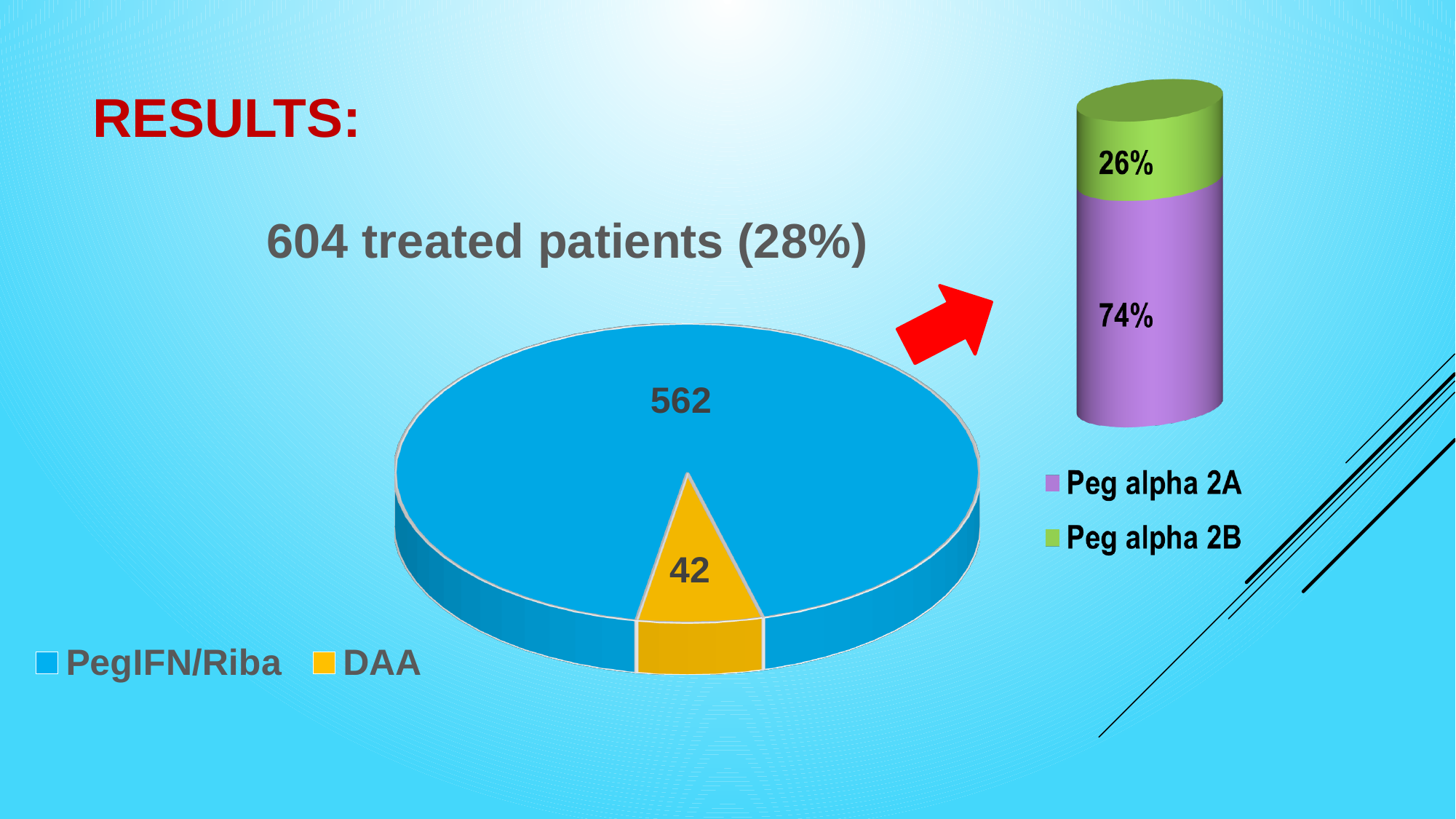
In the stacked bar chart on the right, what is the value for Peg alpha 2B? 26% In the stacked bar chart on the right, what is the value for Peg alpha 2A? 74% In the pie chart, what is the value for PegIFN/Riba? 562 In the pie chart, what is the difference between the PegIFN/Riba value and the DAA value? 520 In the stacked bar chart on the right, which is larger, Peg alpha 2A or Peg alpha 2B? Peg alpha 2A In the pie chart, what is the value for DAA? 42 In the pie chart, what colour is the DAA slice? Yellow What kind of chart is the chart on the left of the slide? Pie chart In the pie chart, which category has the smallest slice? DAA In the pie chart, which category has the largest slice? PegIFN/Riba In the pie chart, how many categories are shown? 2 In the stacked bar chart on the right, how many series does the legend list? 2